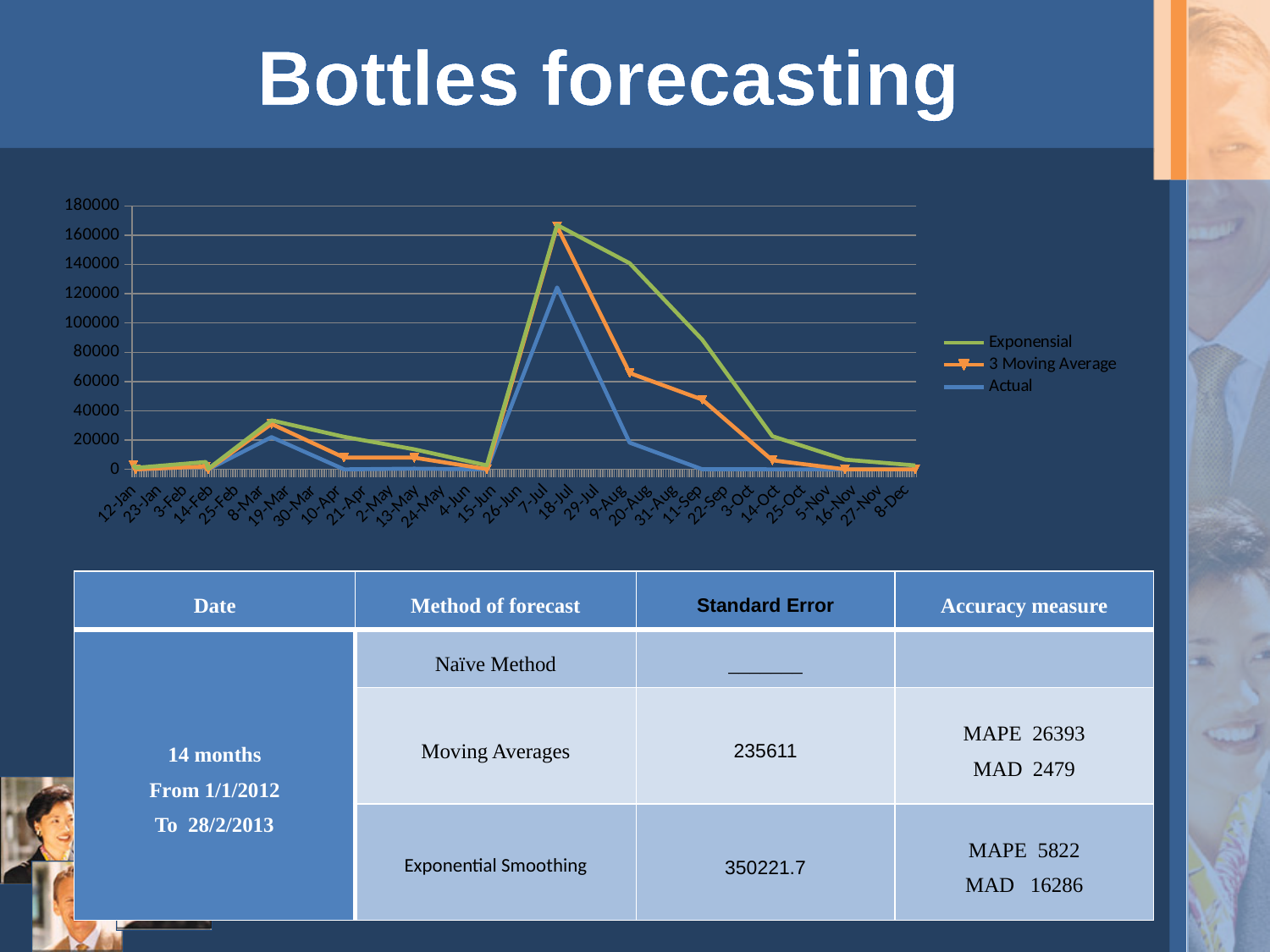
At 11-Sep, which series has the higher value, Exponensial or 3 Moving Average? Exponensial What type of chart is shown on the slide? line chart What are the three series named in the chart legend? Exponensial, 3 Moving Average, Actual At 9-Aug, which series has the higher value, Exponensial or Actual? Exponensial Is the peak value of the Exponensial series greater or less than 140000? greater Does the Actual series rise or fall between 18-Jul and 20-Aug? fall Is the peak value of the Actual series around 18-Jul greater or less than 100000? greater Which series reaches the lowest peak value on the chart? Actual Is the peak value of the 3 Moving Average series greater or less than 140000? greater What is the highest value shown on the chart's vertical axis? 180000 How many series does the chart legend list? 3